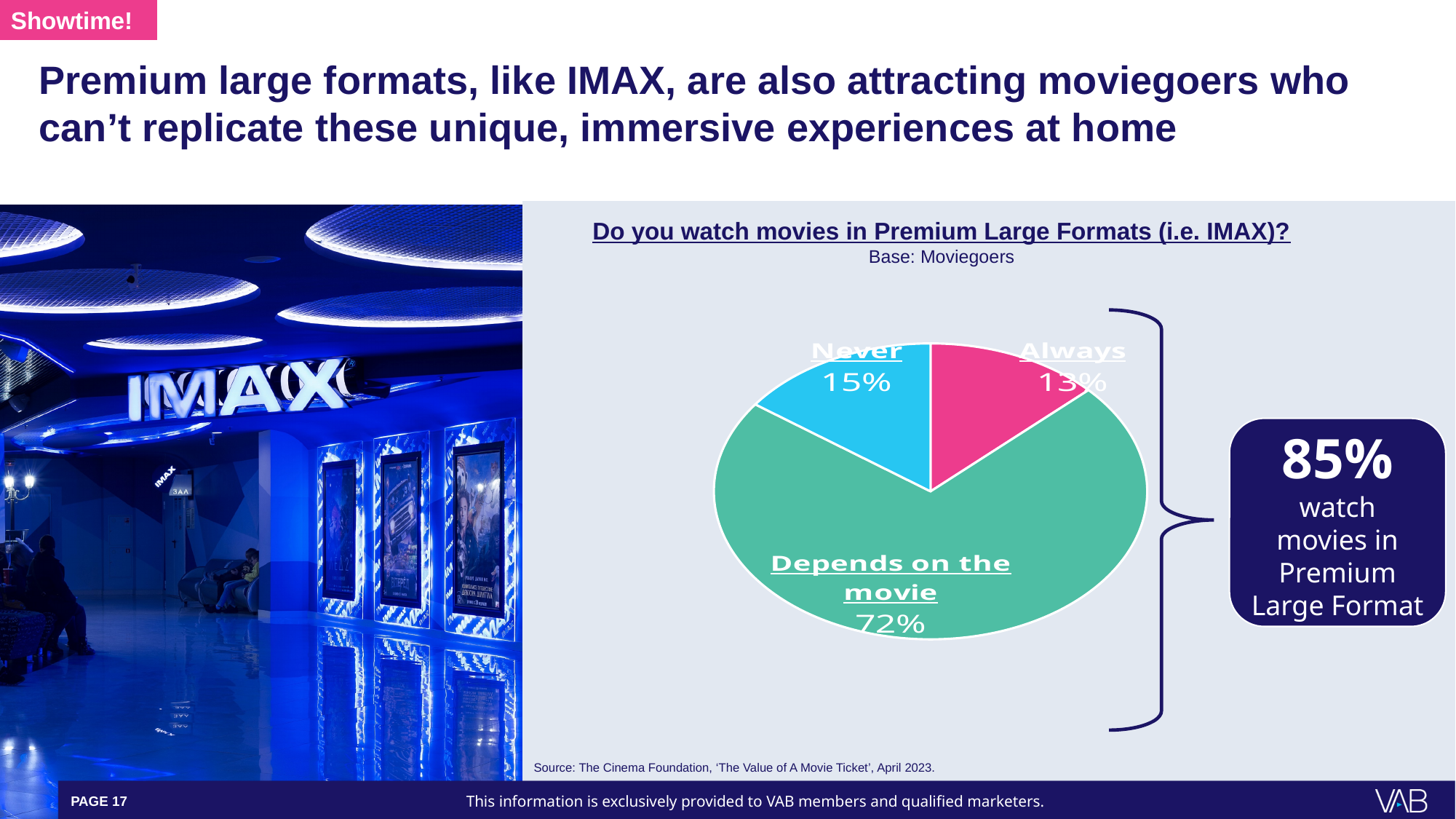
What colour is the "Never" slice of the pie chart? Blue Which response has the smallest share of the pie? Always What kind of chart is shown on the slide? Pie chart What is the difference in percentage points between "Depends on the movie" and "Never"? 57 What percentage of moviegoers answered "Always"? 13% What percentage of moviegoers answered "Never"? 15% Which response has the largest share of the pie? Depends on the movie What percentage of moviegoers answered "Depends on the movie"? 72% What is the difference in percentage points between "Never" and "Always"? 2 What is the title of the pie chart? Do you watch movies in Premium Large Formats (i.e. IMAX)? What is the combined share of "Always" and "Depends on the movie"? 85% How many slices does the pie chart have? 3